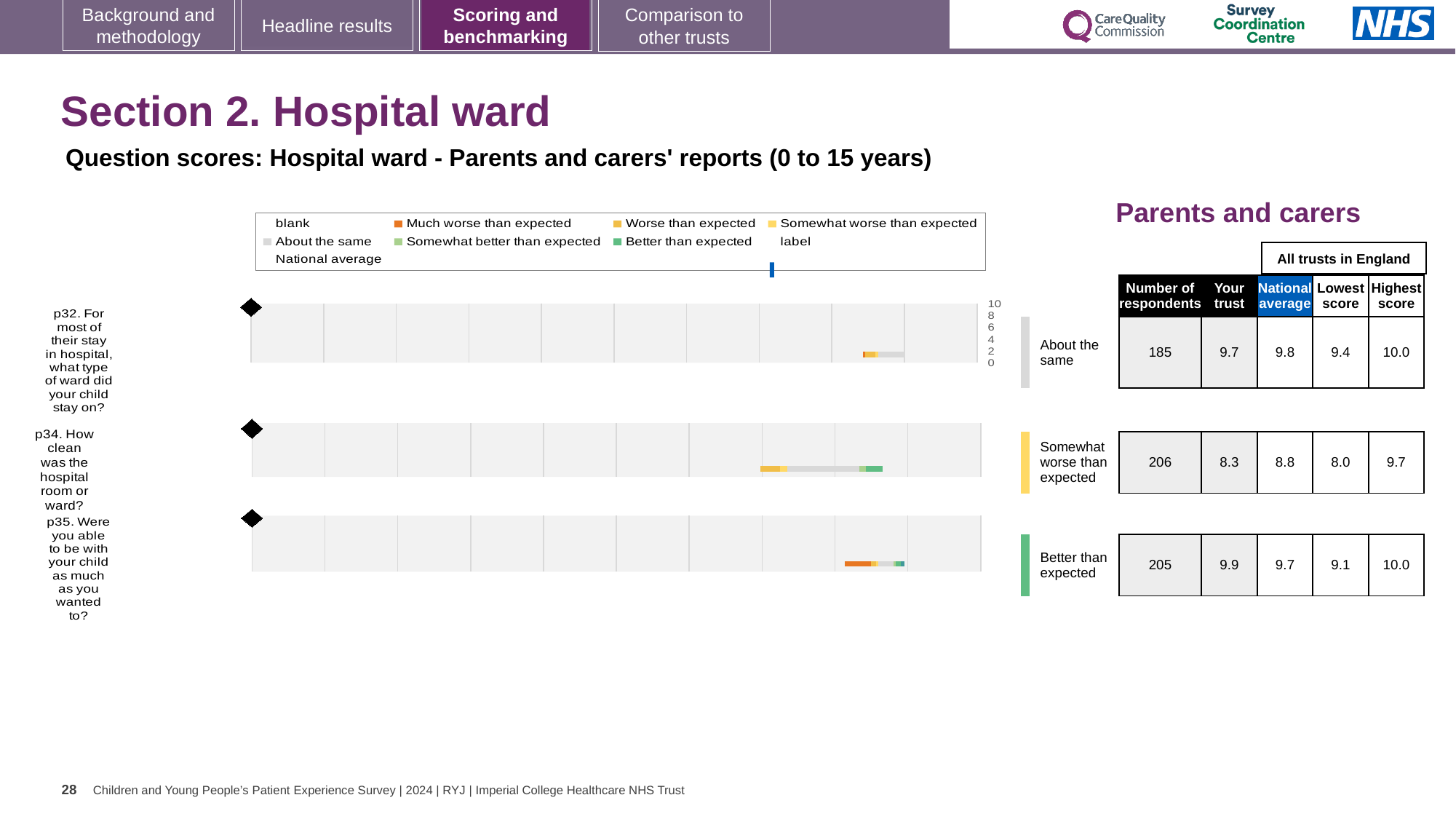
What is the lowest score among all trusts in England for p35? 9.1 For p35, which is larger: the 'Your trust' score or the national average? Your trust How many questions (p32, p34, p35) are plotted on the slide? 3 Which question has the highest 'Your trust' score? p35 What kind of chart is used to show the question scores on this slide? bar chart What is the difference between the national average and the 'Your trust' score for p34? 0.5 What is the national average score for p34 (how clean was the hospital room or ward)? 8.8 Which question has the lowest 'Your trust' score? p34 How many respondents answered p34? 206 What benchmark category is p34 (how clean was the hospital room or ward) assigned to? Somewhat worse than expected What is the 'Your trust' score for p32 (what type of ward did your child stay on)? 9.7 What is the 'Your trust' score for p35 (were you able to be with your child as much as you wanted to)? 9.9